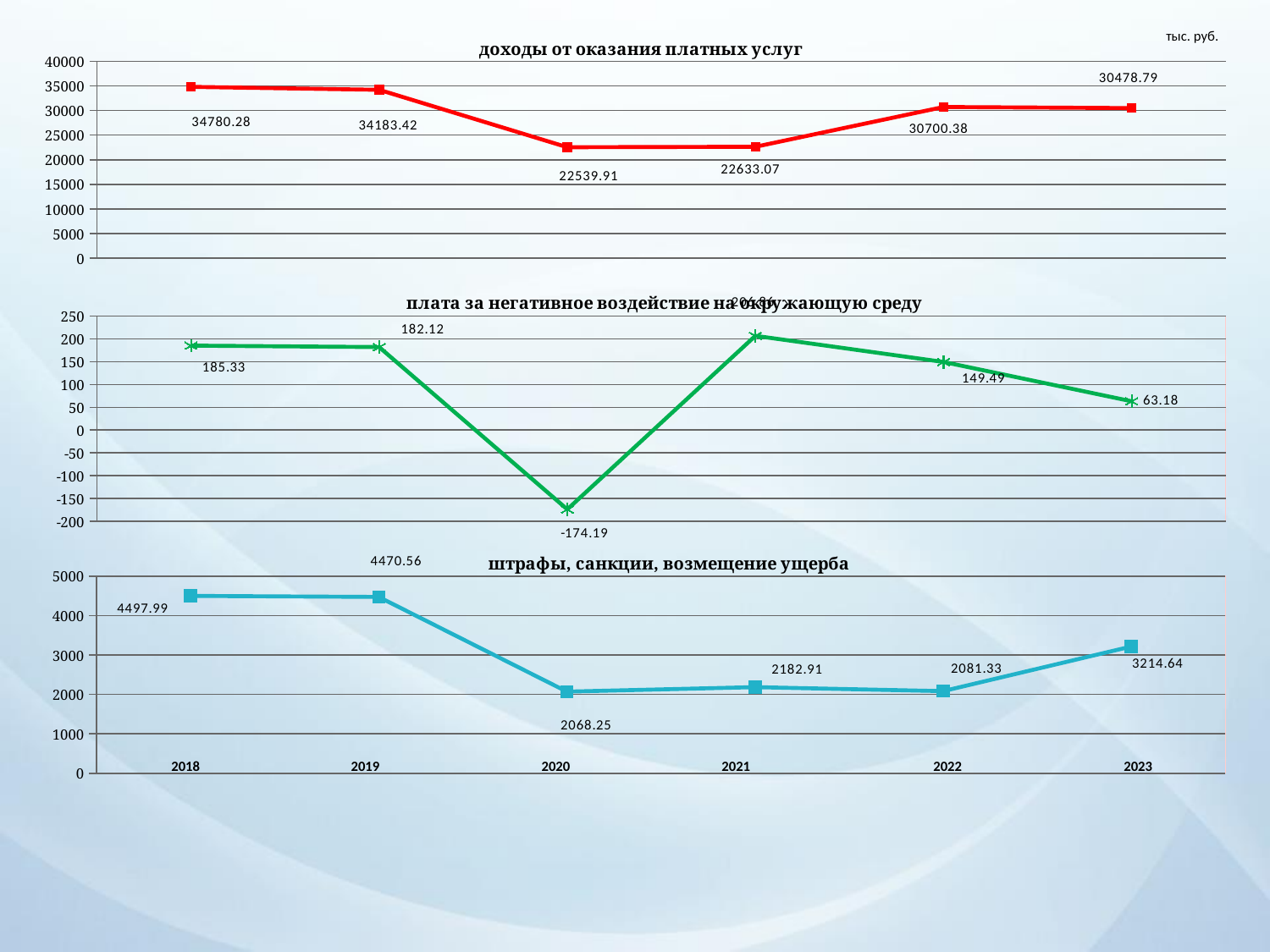
In the chart titled 'штрафы, санкции, возмещение ущерба', what is the value for 2018? 4497.99 In the chart titled 'доходы от оказания платных услуг', what is the value of the first data point (2018)? 34780.28 In the chart titled 'штрафы, санкции, возмещение ущерба', which year has the lowest value? 2020 In the chart titled 'доходы от оказания платных услуг', what is the difference between the first value (34780.28) and the second value (34183.42)? 596.86 How many data points are plotted in the chart titled 'штрафы, санкции, возмещение ущерба'? 6 In the chart titled 'доходы от оказания платных услуг', what is the value of the last data point (2023)? 30478.79 What type of chart is the top chart titled 'доходы от оказания платных услуг'? line chart In the chart titled 'доходы от оказания платных услуг', what is the lowest value shown? 22539.91 In the chart titled 'штрафы, санкции, возмещение ущерба', which is larger, the value for 2021 or the value for 2023? 2023 In the chart titled 'плата за негативное воздействие на окружающую среду', what is the value of the last data point (2023)? 63.18 In the chart titled 'плата за негативное воздействие на окружающую среду', what is the value of the third data point (2020)? -174.19 In the chart titled 'плата за негативное воздействие на окружающую среду', is the value for 2022 greater or less than 100? greater